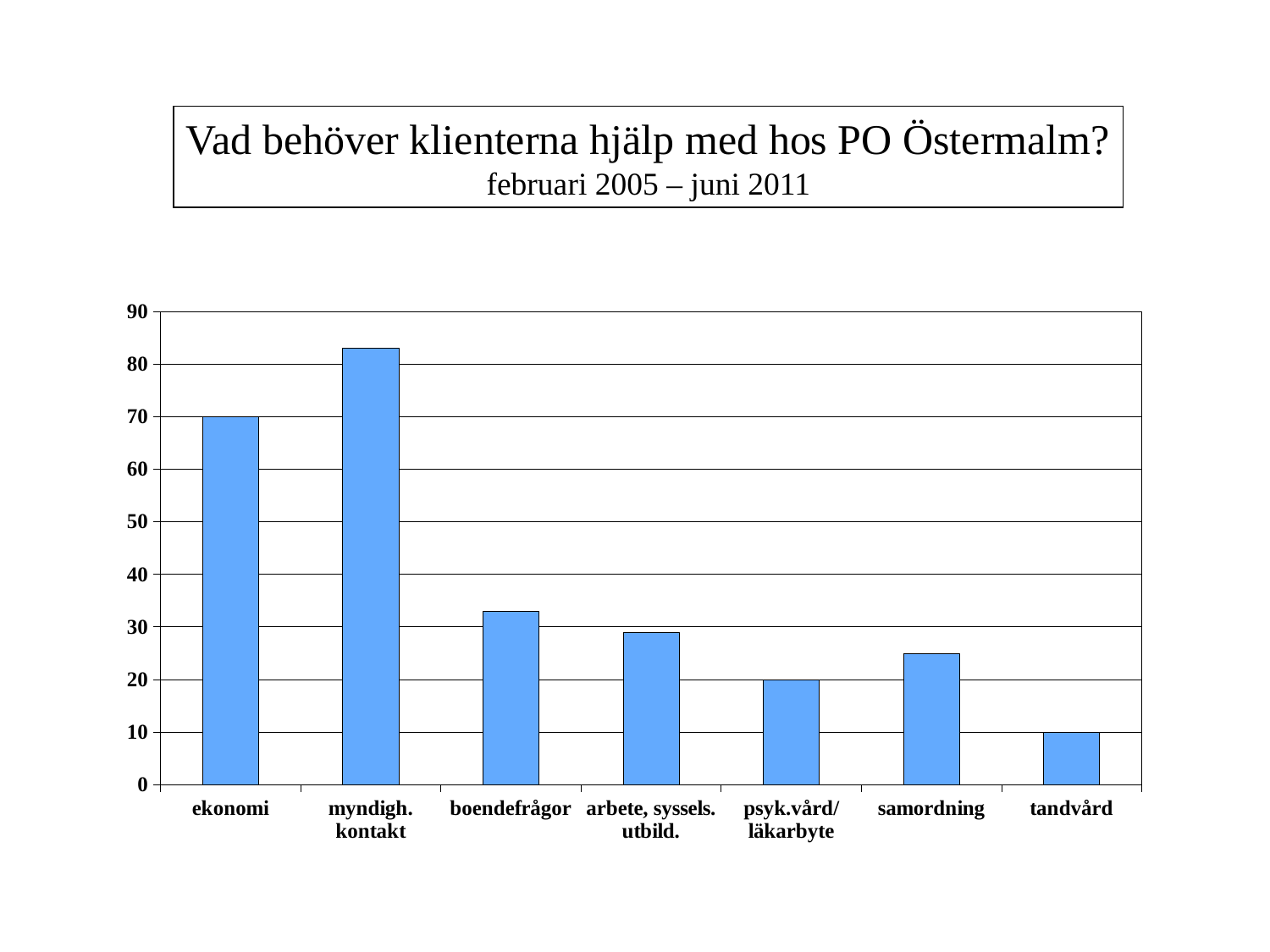
Which category has the highest bar in the chart? myndigh. kontakt How many categories are shown on the x axis of the chart? 7 Which category has the lowest bar in the chart? tandvård What is the value for tandvård? 10 What is the value for ekonomi? 70 Is the value for samordning greater or less than 30? less What is the value for psyk.vård/läkarbyte? 20 Which is larger, the value for boendefrågor or the value for arbete, syssels. utbild.? boendefrågor Is the value for myndigh. kontakt greater or less than 80? greater Is the value for boendefrågor greater or less than 30? greater What period does the chart title say the data covers? februari 2005 – juni 2011 What kind of chart is shown on the slide? bar chart